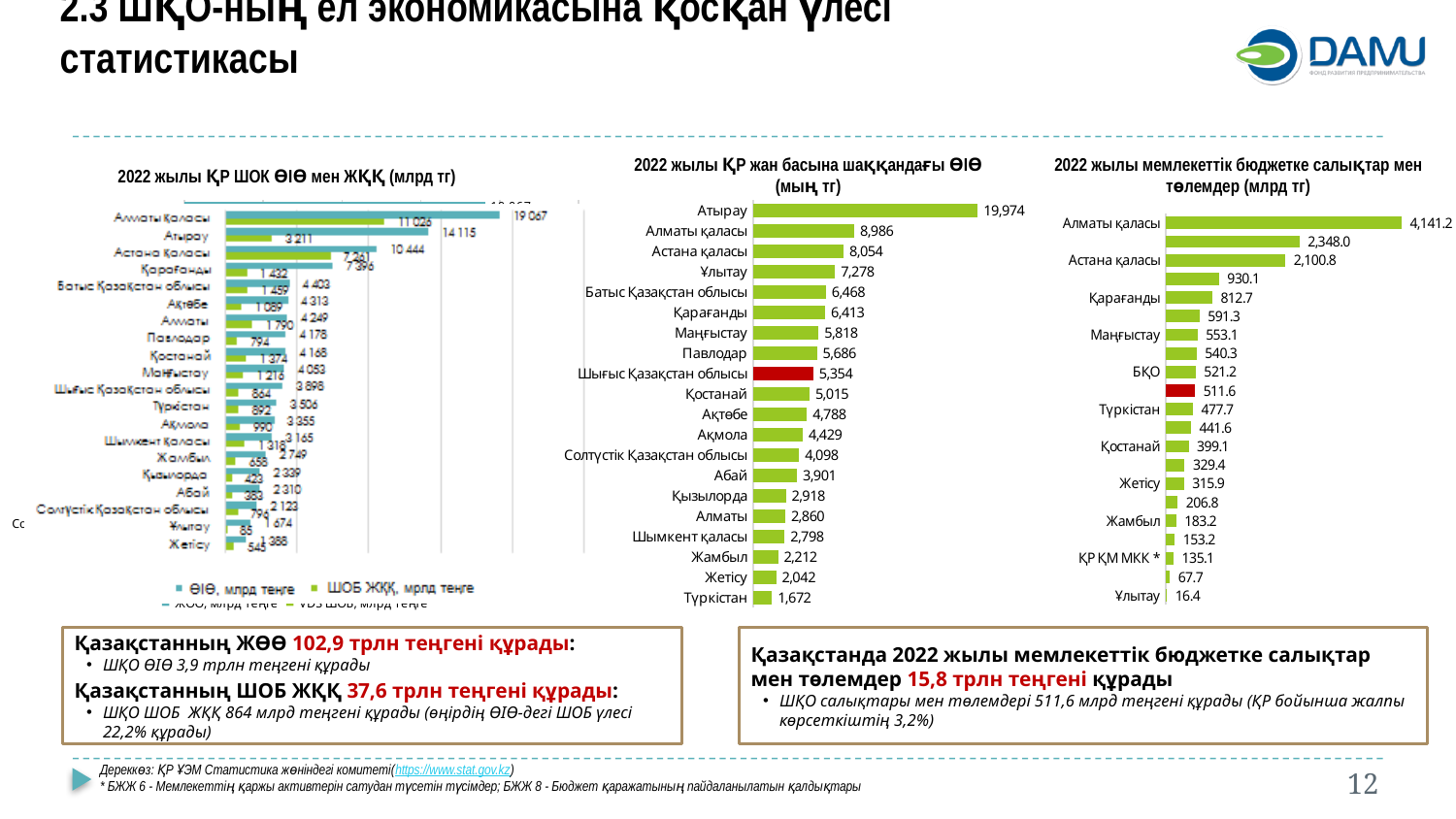
In the chart titled "2022 жылы ҚР жан басына шаққандағы ӨІӨ (мың тг)", which region has the highest value? Атырау In the chart titled "2022 жылы ҚР жан басына шаққандағы ӨІӨ (мың тг)", how many regions are plotted? 20 In the chart titled "2022 жылы ҚР жан басына шаққандағы ӨІӨ (мың тг)", which region's bar is coloured red? Шығыс Қазақстан облысы In the chart titled "2022 жылы мемлекеттік бюджетке салықтар мен төлемдер (млрд тг)", what is the value for Алматы қаласы? 4,141.2 In the chart titled "2022 жылы ҚР жан басына шаққандағы ӨІӨ (мың тг)", what is the value for Атырау? 19,974 What kind of chart is the one titled "2022 жылы ҚР жан басына шаққандағы ӨІӨ (мың тг)"? Bar chart In the chart titled "2022 жылы мемлекеттік бюджетке салықтар мен төлемдер (млрд тг)", which region has the lowest value? Ұлытау In the chart titled "2022 жылы мемлекеттік бюджетке салықтар мен төлемдер (млрд тг)", what is the value for Қостанай? 399.1 In the chart titled "2022 жылы ҚР жан басына шаққандағы ӨІӨ (мың тг)", which region has the lowest value? Түркістан In the chart titled "2022 жылы ҚР жан басына шаққандағы ӨІӨ (мың тг)", what is the difference between Алматы қаласы and Астана қаласы? 932 In the chart titled "2022 жылы ҚР жан басына шаққандағы ӨІӨ (мың тг)", which is larger: Ұлытау or Павлодар? Ұлытау In the chart titled "2022 жылы мемлекеттік бюджетке салықтар мен төлемдер (млрд тг)", what is the difference between Алматы қаласы and Астана қаласы? 2,040.4